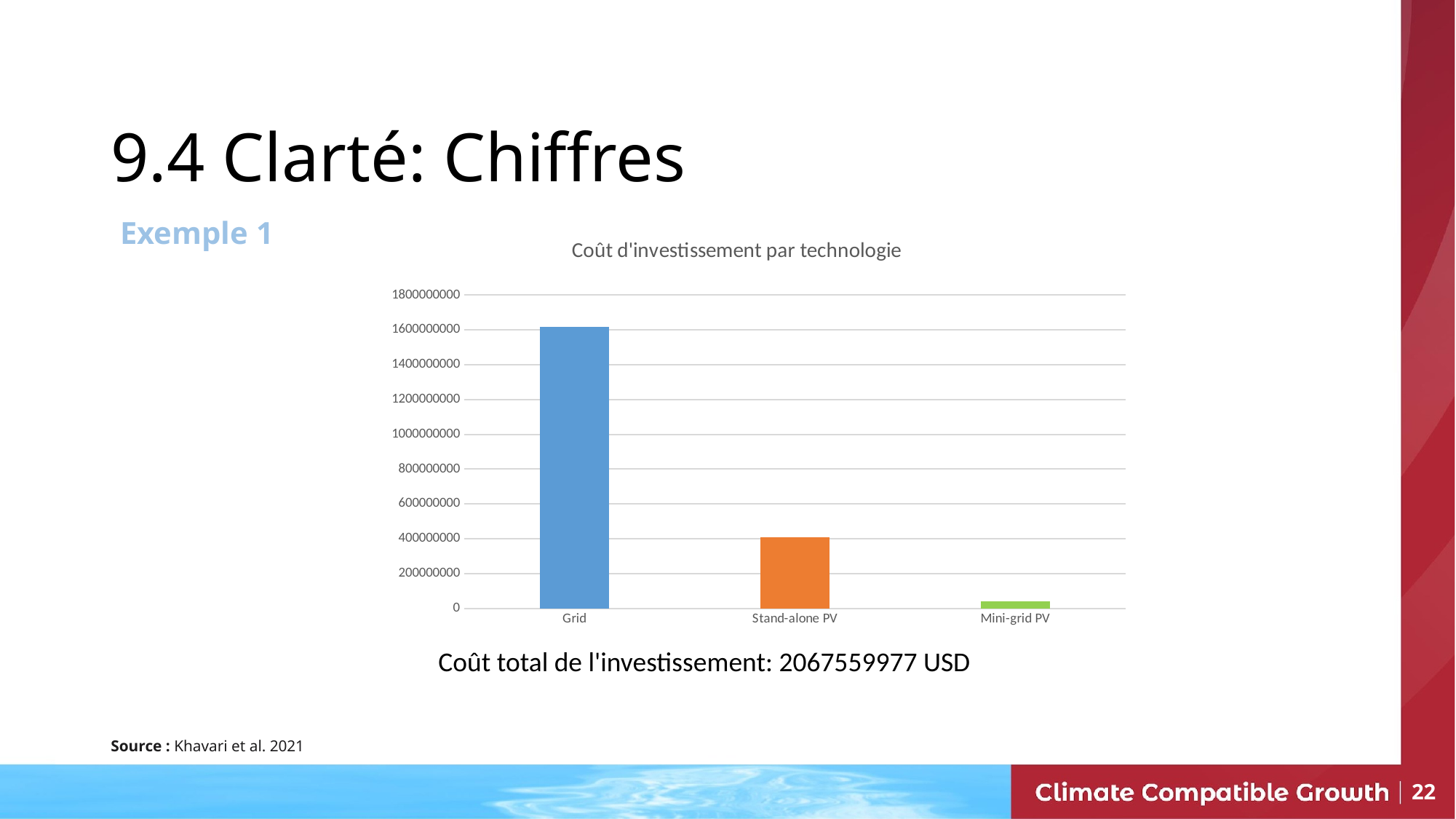
Do the bar values rise or fall from left to right across the categories? fall How many technology categories are plotted in the chart? 3 Is the value for Grid greater or less than 1400000000? greater Which technology has the lowest investment cost in the chart? Mini-grid PV Is the value for Stand-alone PV greater or less than 600000000? less Is the value for Grid greater or less than 1800000000? less Which technology has the highest investment cost in the chart? Grid What kind of chart is shown on the slide? Bar chart What total investment cost is stated in the text below the chart? 2067559977 USD What is the title of the chart? Coût d'investissement par technologie Which has a larger investment cost, Stand-alone PV or Mini-grid PV? Stand-alone PV